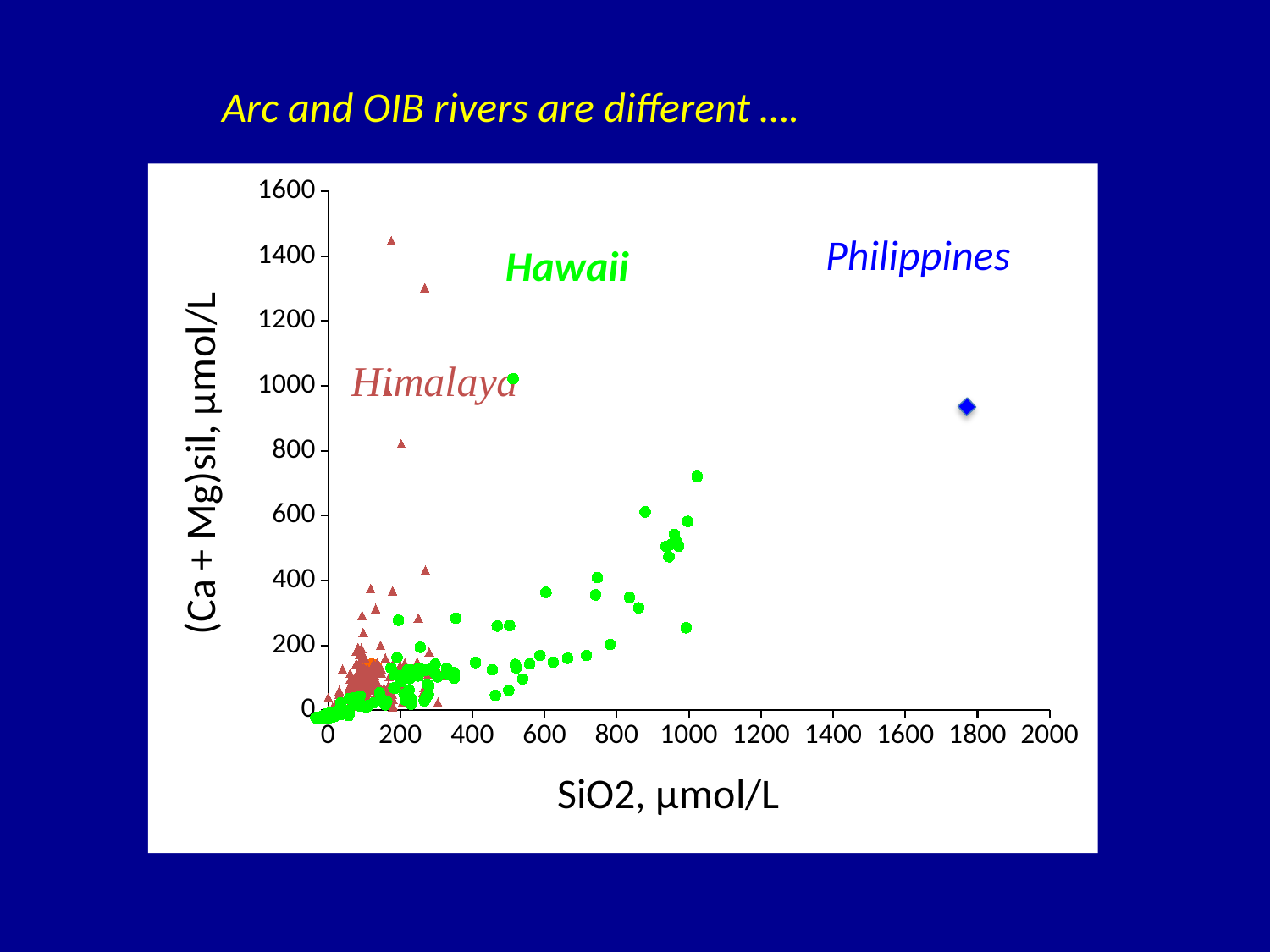
Is the SiO2 value of the Philippines point greater or less than 1600? greater What is the title of the slide above the chart? Arc and OIB rivers are different …. How many data series (groups) are labelled on the chart? 3 Is the (Ca + Mg)sil value of the Philippines point greater or less than 1000? less Is the highest Himalaya point's (Ca + Mg)sil value greater or less than 1200? greater What is the label of the x axis? SiO2, µmol/L Which series contains the point with the highest (Ca + Mg)sil value? Himalaya What kind of chart is shown on the slide? scatter chart How many Philippines points are plotted on the chart? 1 Which series has the point with the largest SiO2 value? Philippines Which series has the higher maximum (Ca + Mg)sil value, Hawaii or Philippines? Hawaii